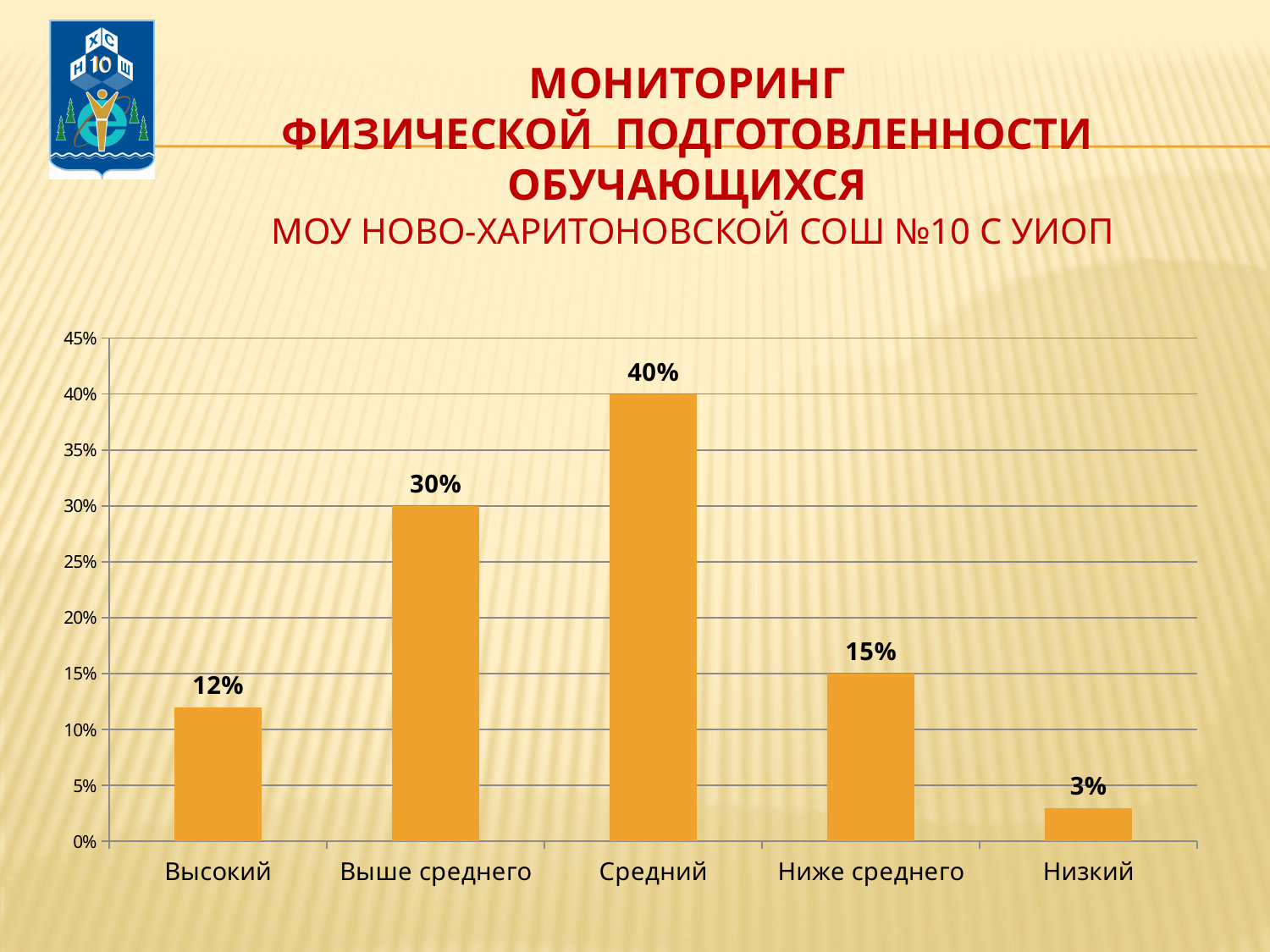
Which category has the highest value? Средний What kind of chart is shown on the slide? bar chart Which category has the lowest value? Низкий What is the value for Высокий? 12% How many categories are shown on the x axis? 5 What is the value for Низкий? 3% What is the difference between the values for Ниже среднего and Низкий? 12% Which is larger, the value for Выше среднего or the value for Ниже среднего? Выше среднего What is the value for Средний? 40% What is the highest value shown on the vertical axis? 45% What is the difference between the values for Средний and Выше среднего? 10% What is the value for Ниже среднего? 15%